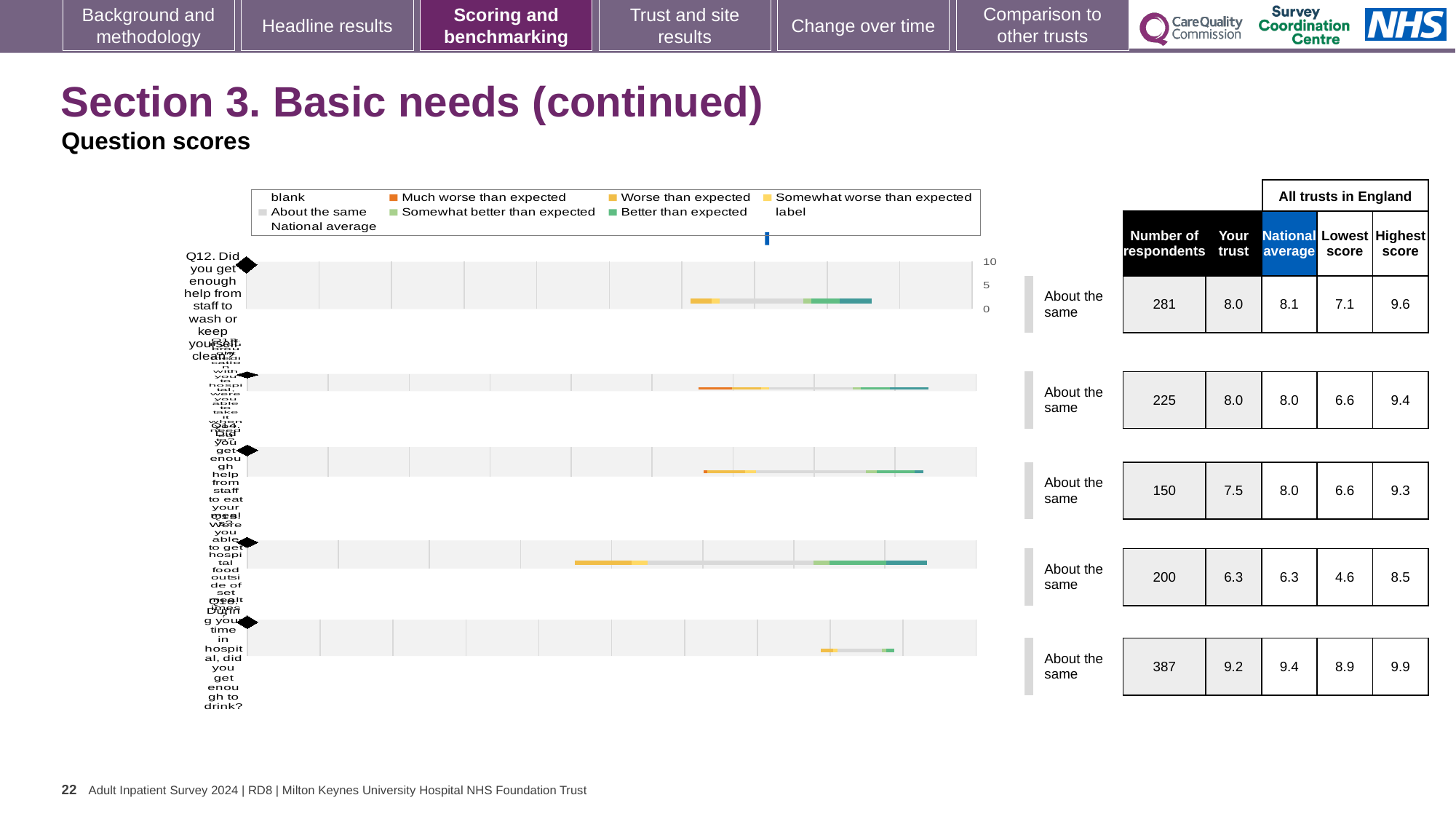
Which bar has the highest 'Your trust' score? the fifth (bottom) bar, 9.2 What is the number of respondents for the first bar (Q12)? 281 How many question bars are plotted in the chart? 5 What is the highest score among all trusts in England for the fifth (bottom) bar? 9.9 What benchmark category is shown for every bar in the chart? About the same For the third bar from the top, which is larger: the 'Your trust' score or the national average? National average Which bar has the lowest 'Your trust' score? the fourth bar, 6.3 For the first bar (Q12), what is the difference between the highest score and the lowest score across all trusts in England? 2.5 What kind of chart is shown on the slide? bar chart What is the number of respondents for the fifth (bottom) bar? 387 What is the 'Your trust' score for the first bar (Q12, help from staff to wash or keep yourself clean)? 8.0 What is the national average for the fourth bar from the top? 6.3